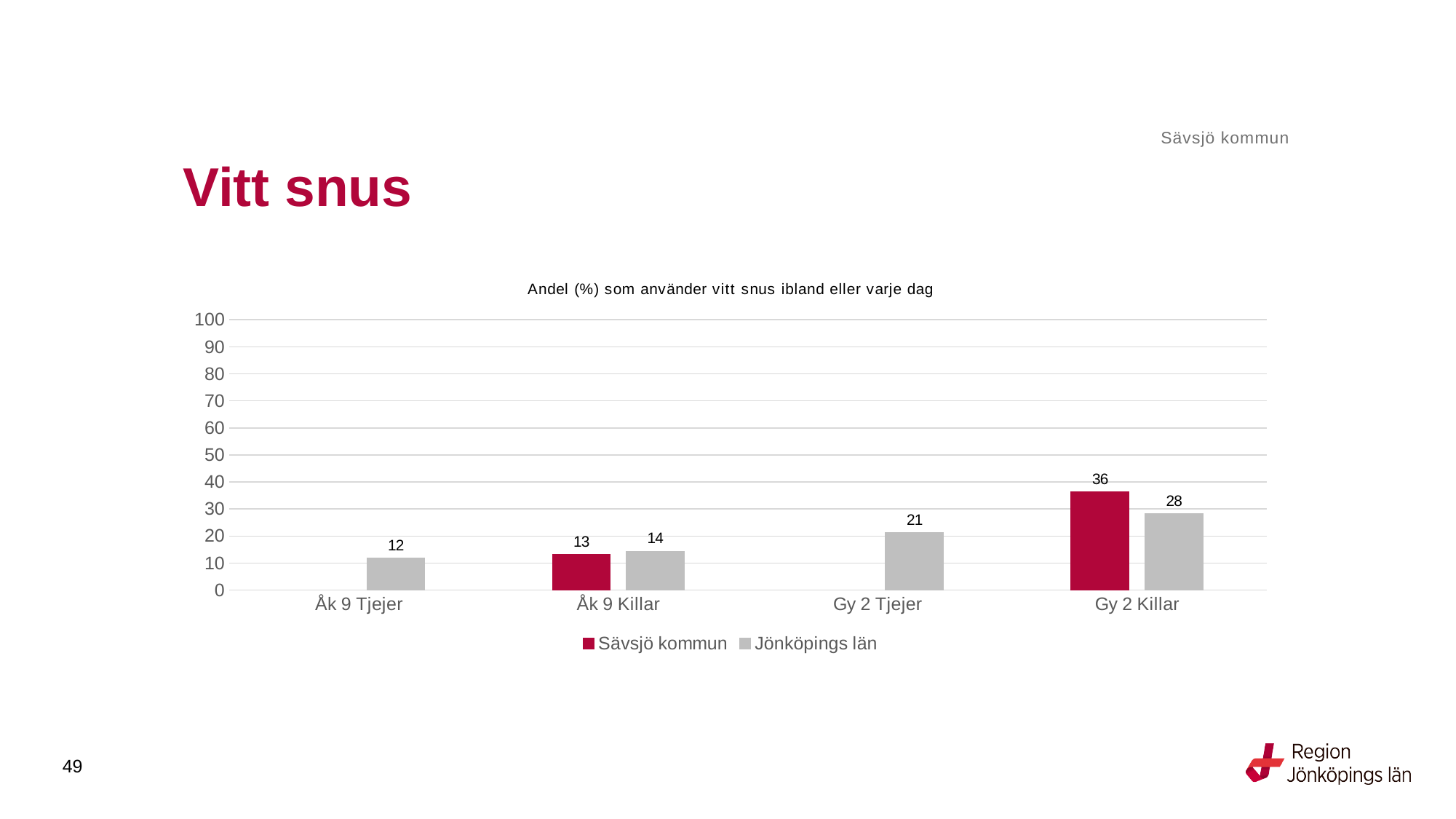
What is the value for Jönköpings län in the Gy 2 Tjejer category? 21 How many series does the legend list? 2 In the Gy 2 Killar category, which is larger: Sävsjö kommun or Jönköpings län? Sävsjö kommun Which category has the lowest value for Jönköpings län? Åk 9 Tjejer Is the value for Jönköpings län in Gy 2 Tjejer greater or less than 30? less How many categories are shown on the x axis? 4 Which category has the highest value for Jönköpings län? Gy 2 Killar What is the value for Sävsjö kommun in the Åk 9 Killar category? 13 What kind of chart is shown on the slide? bar chart What is the value for Jönköpings län in the Åk 9 Tjejer category? 12 What is the value for Sävsjö kommun in the Gy 2 Killar category? 36 What is the difference between Sävsjö kommun and Jönköpings län in the Gy 2 Killar category? 8